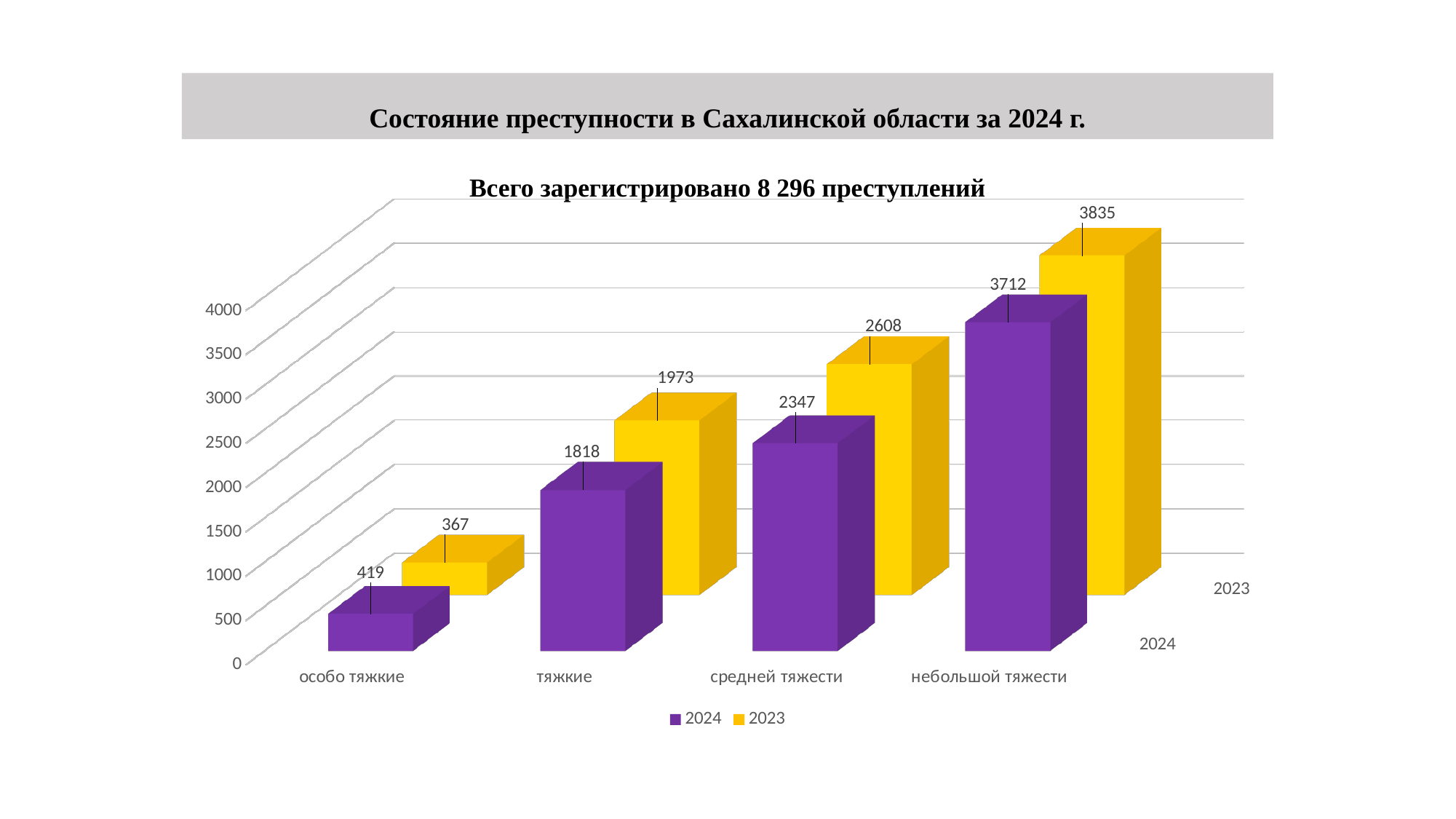
What is the difference between the 2023 and 2024 values for "средней тяжести"? 261 What kind of chart is shown on the slide? bar chart What is the value for 2024 in the category "небольшой тяжести"? 3712 How many series does the legend list? 2 What is the value for 2023 in the category "тяжкие"? 1973 Do the 2024 values rise or fall from "особо тяжкие" to "небольшой тяжести"? rise How many categories are shown on the x axis? 4 What is the title of the chart? Всего зарегистрировано 8 296 преступлений What is the value for 2024 in the category "особо тяжкие"? 419 Which is larger in the category "особо тяжкие": the 2024 value or the 2023 value? 2024 Which category has the lowest value for the 2024 series? особо тяжкие Which category has the highest value for the 2023 series? небольшой тяжести